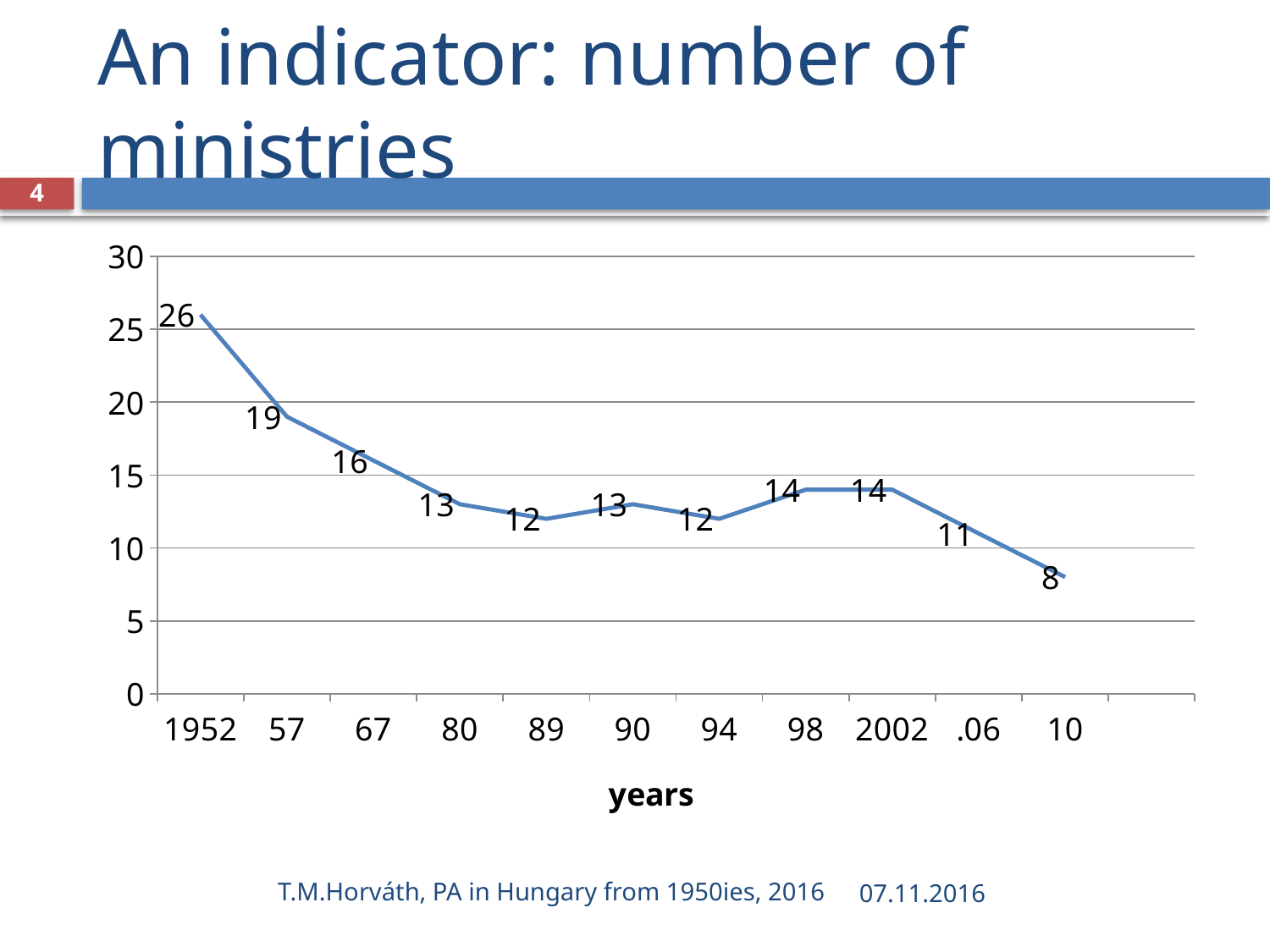
What is the number of ministries in 2002? 14 Which year has the highest number of ministries? 1952 What is the number of ministries in 10 (2010)? 8 What is the number of ministries in 80? 13 What is the title of the x axis? years Which year has the lowest number of ministries? 10 What is the number of ministries in 1952? 26 What is the difference between the number of ministries in 1952 and in 57? 7 Which is larger, the number of ministries in 67 or in 98? 67 What kind of chart is shown on the slide? line chart What is the difference between the number of ministries in 2002 and in .06? 3 How many data points are plotted on the chart? 11